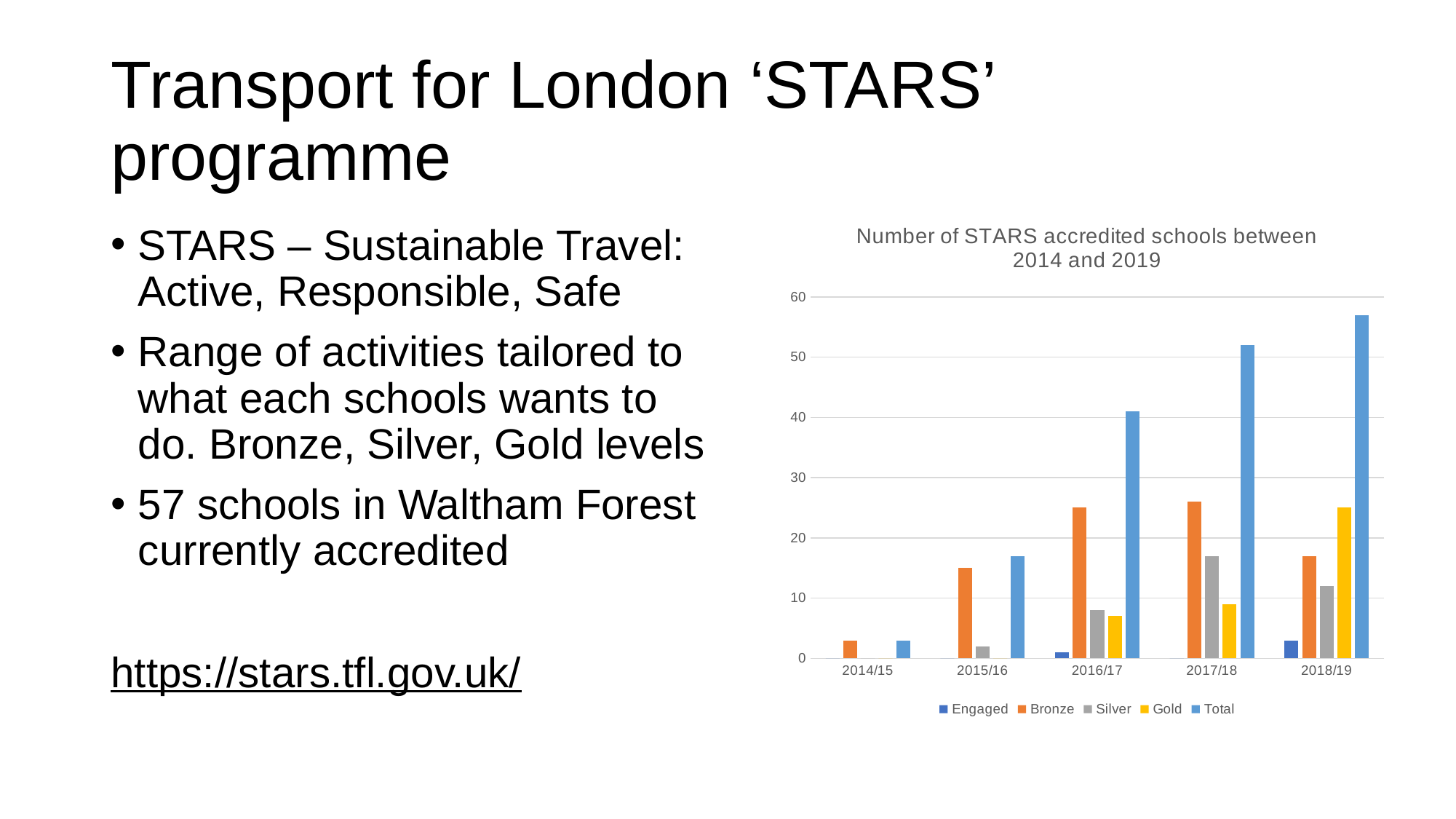
Is the Bronze value for 2016/17 greater or less than 20? greater Is the Total value for 2015/16 greater or less than 20? less What kind of chart is shown on the slide? bar chart How many academic years are shown on the x axis? 5 Which year has the highest Total value? 2018/19 How many series does the legend list? 5 Which year has the lowest Total value? 2014/15 What is the title of the chart? Number of STARS accredited schools between 2014 and 2019 Is the Total value for 2018/19 greater or less than 50? greater In 2018/19, which is larger: Bronze or Gold? Gold Which year has the highest Gold value? 2018/19 Does the Total series rise or fall from 2014/15 to 2018/19? rise